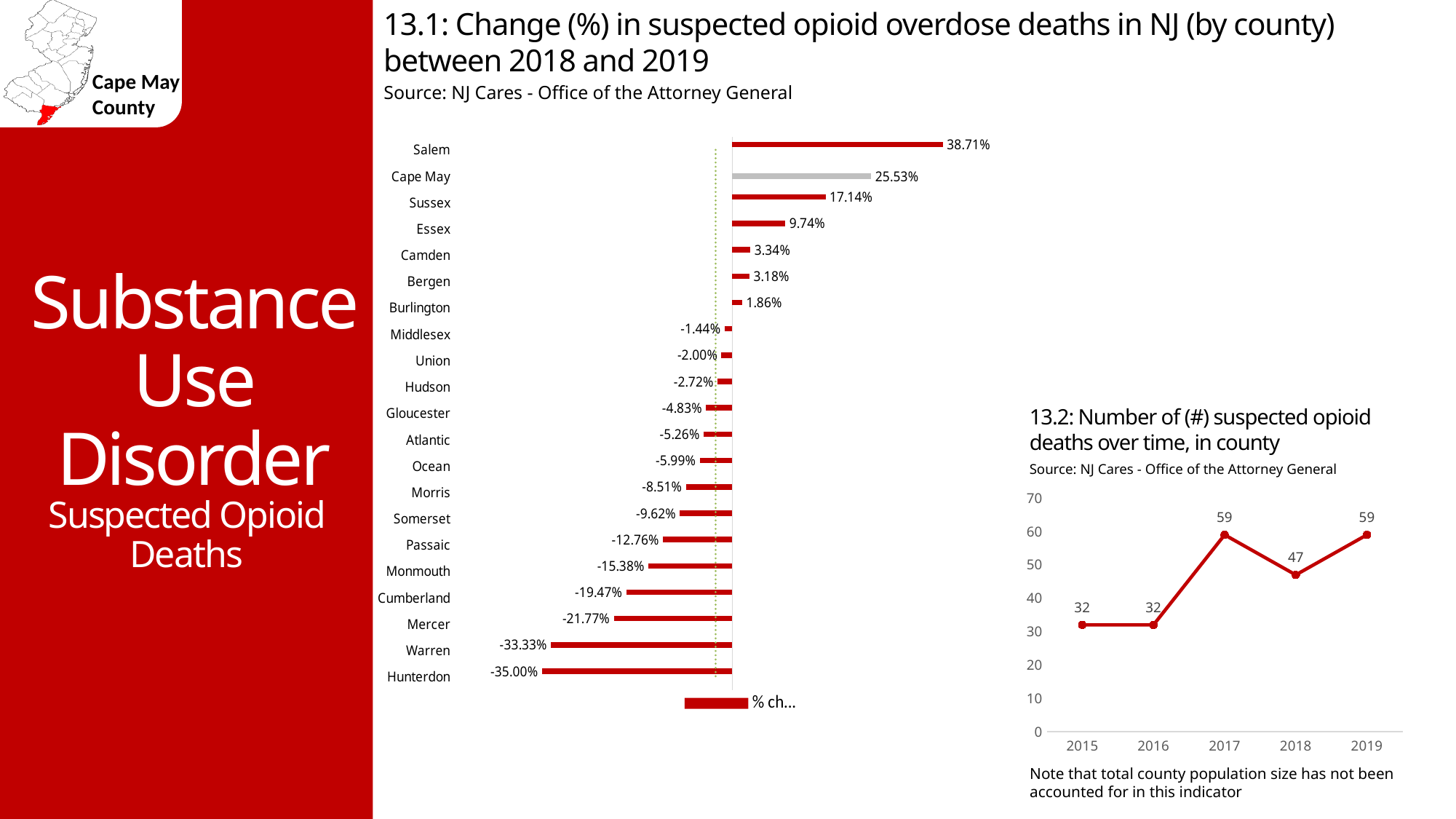
In chart 13.2 (Number of suspected opioid deaths over time, in county), what is the value for 2018? 47 In chart 13.1 (Change (%) in suspected opioid overdose deaths in NJ by county), what is the value for Cape May? 25.53% In chart 13.1, which county has the highest percentage change? Salem In chart 13.1, what kind of chart is used? Bar chart In chart 13.1, what is the difference between the values for Salem and Cape May? 13.18% In chart 13.2, what is the difference between the values for 2017 and 2016? 27 In chart 13.1, how many counties are shown? 21 In chart 13.2, how many years are plotted? 5 In chart 13.1, which is larger, the value for Sussex or the value for Essex? Sussex In chart 13.1, which county has the lowest percentage change? Hunterdon In chart 13.1, what is the value for Warren? -33.33% In chart 13.2, what kind of chart is used? Line chart